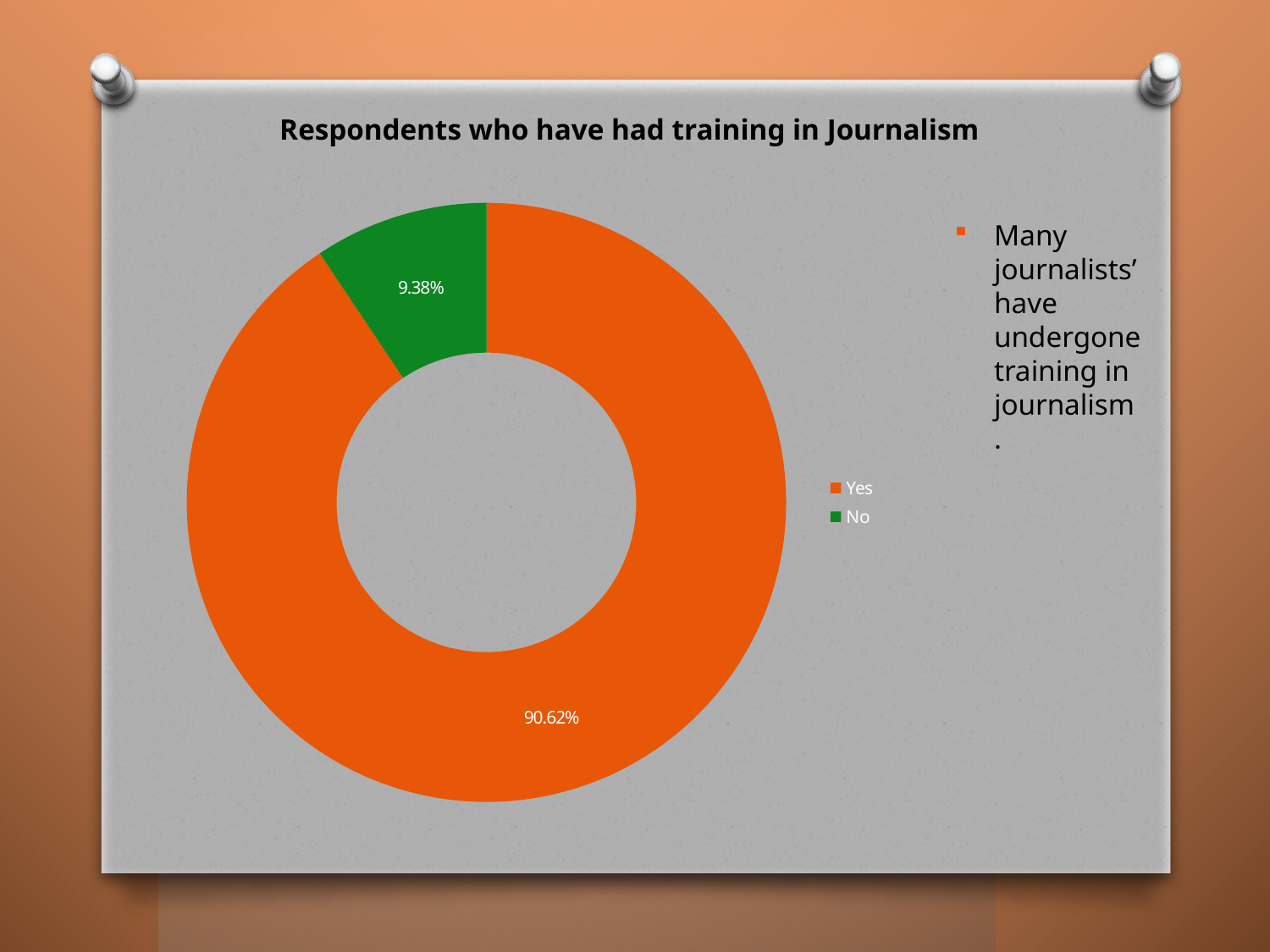
Which is larger, the share for Yes or the share for No? Yes What is the difference in percentage points between the Yes and No shares? 81.24 Which category has the largest share of the chart? Yes How many entries does the legend list? 2 What is the title of the chart? Respondents who have had training in Journalism How many categories are shown in the chart? 2 What percentage of respondents answered No to having had training in journalism? 9.38% What colour represents the No category in the chart? Green Which category has the smallest share of the chart? No What kind of chart is shown on the slide? Doughnut (pie) chart What percentage of respondents answered Yes to having had training in journalism? 90.62%